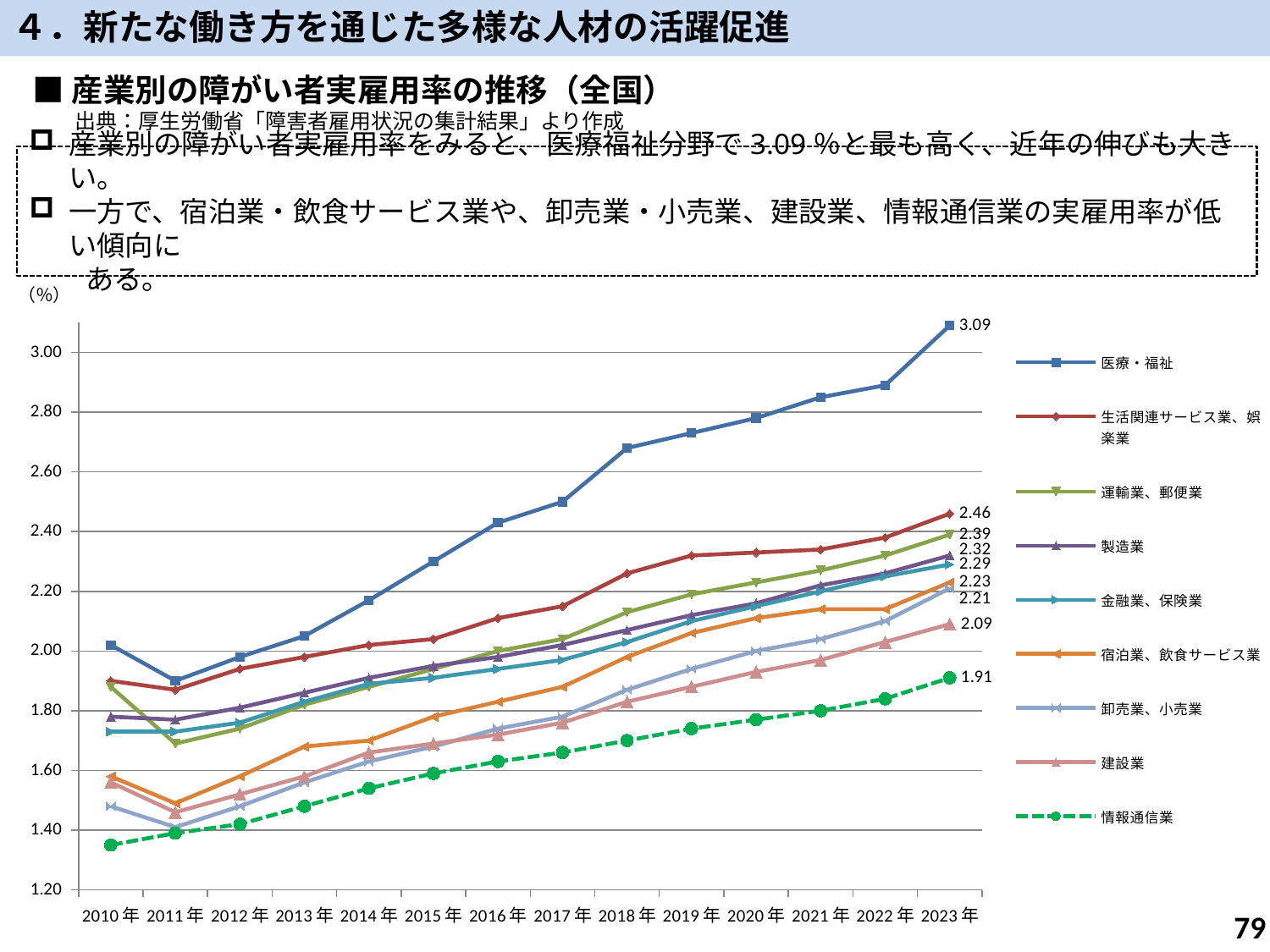
What is the value for 建設業 in 2023年? 2.09 In 2023年, which is larger: 製造業 or 金融業、保険業? 製造業 Is the value for 医療・福祉 in 2018年 greater or less than 2.60? greater What kind of chart is shown on the slide? line chart Which industry has the lowest employment rate in 2023年? 情報通信業 How many series does the legend list? 9 What unit is shown at the top of the vertical axis? (%) Which industry has the highest employment rate in 2023年? 医療・福祉 How many years are shown along the x axis? 14 What is the value for 医療・福祉 in 2023年? 3.09 What is the value for 情報通信業 in 2023年? 1.91 What is the difference between 医療・福祉 and 情報通信業 in 2023年? 1.18